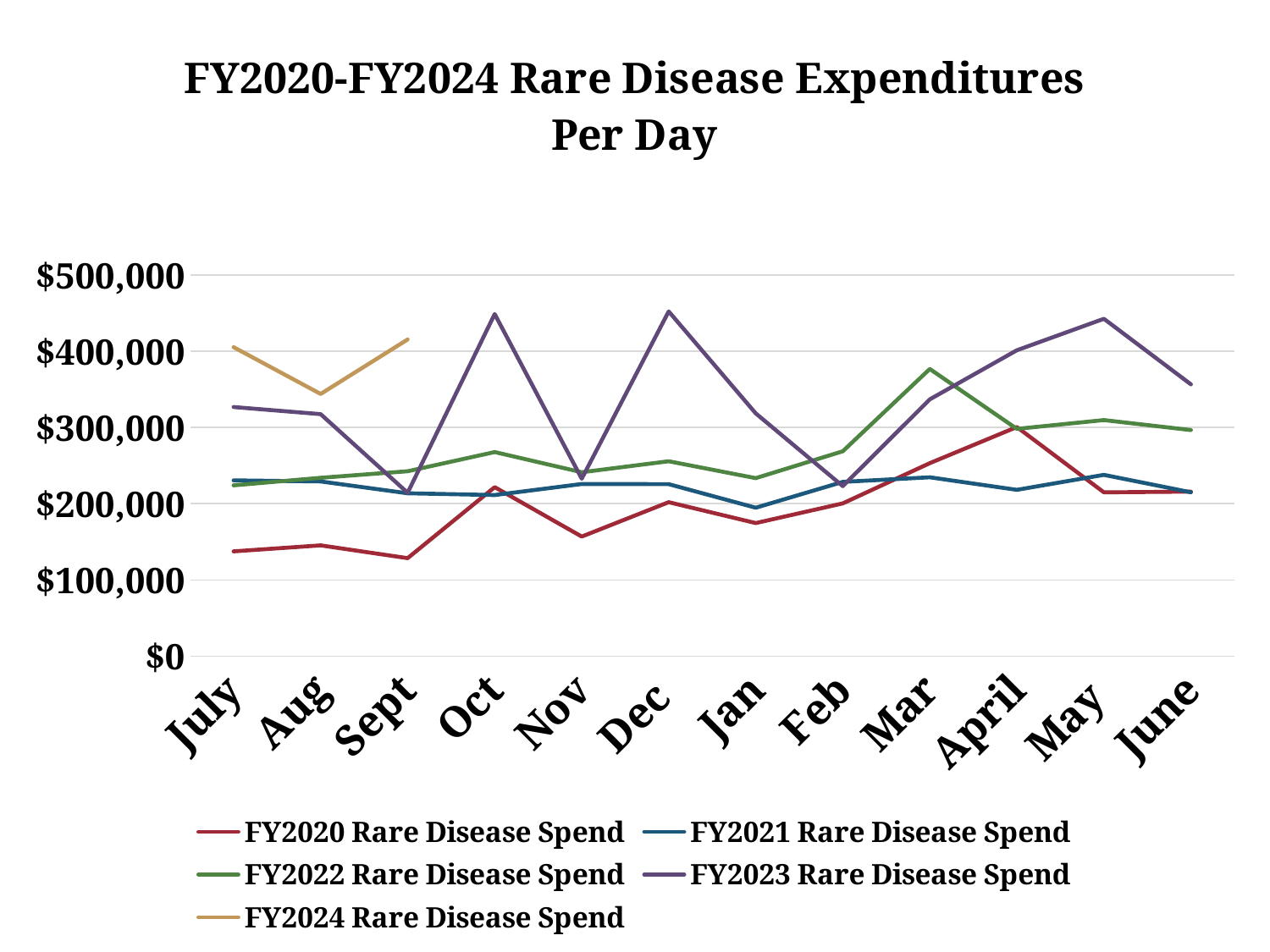
Is the FY2020 Rare Disease Spend value for July greater or less than $200,000? less Is the FY2022 Rare Disease Spend value for Mar greater or less than $300,000? greater In Mar, which is larger: FY2022 Rare Disease Spend or FY2020 Rare Disease Spend? FY2022 Rare Disease Spend How many series does the legend list? 5 What kind of chart is shown on the slide? line chart Which series has the lowest value in Sept? FY2020 Rare Disease Spend Which series has the highest value in May? FY2023 Rare Disease Spend How many months are shown along the x axis? 12 Is the FY2023 Rare Disease Spend value for Oct greater or less than $400,000? greater For how many months does the FY2024 Rare Disease Spend line have data points? 3 In which month does the FY2022 Rare Disease Spend line reach its highest value? Mar